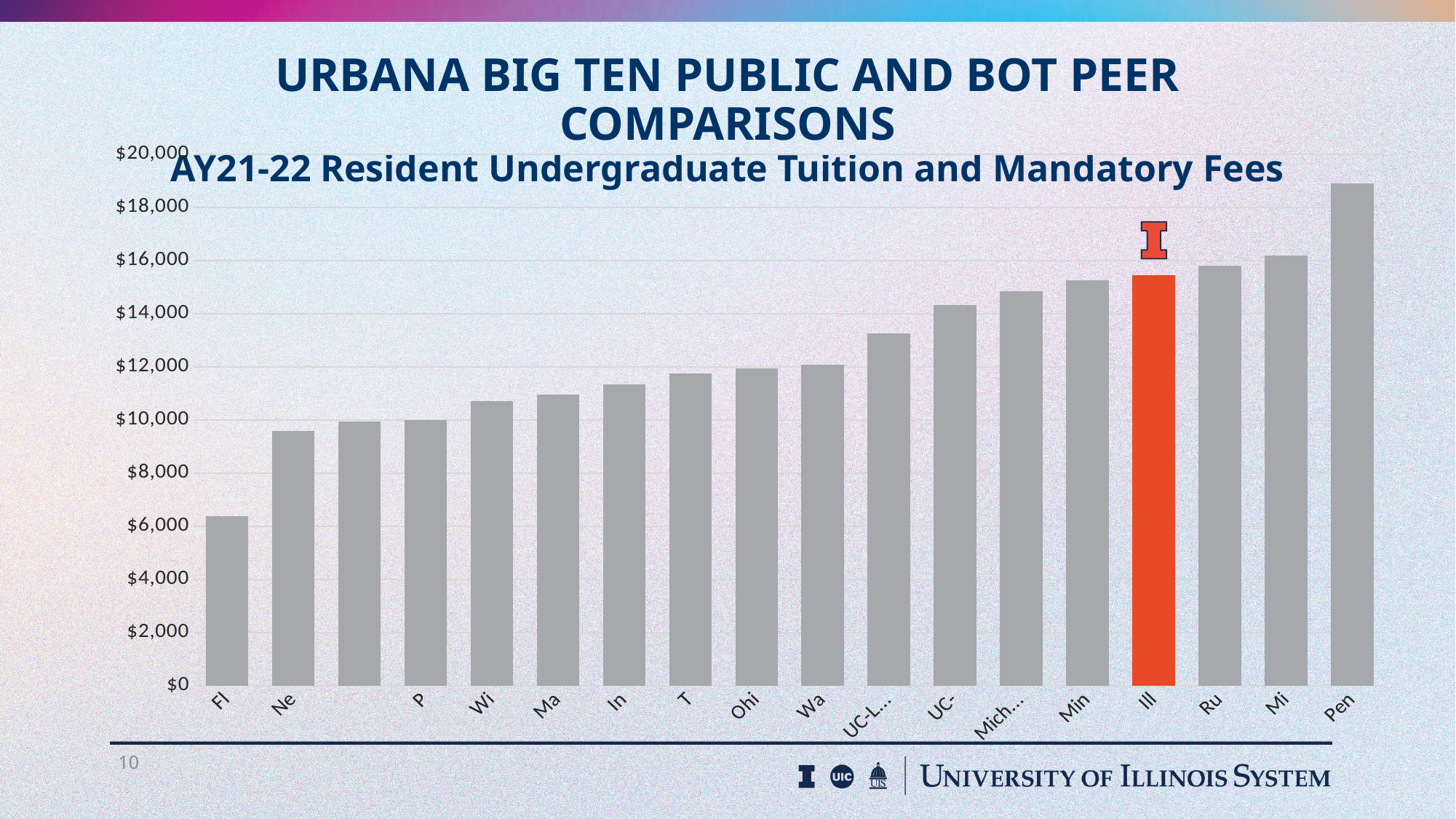
Do the values generally rise or fall from left to right along the x axis? rise Is the value for Ne greater or less than $10,000? less Is the value for Ill greater or less than $14,000? greater Is the value for UC-L... greater or less than $12,000? greater Which category has the lowest value in the chart? Fl What kind of chart is shown on the slide? Bar chart Which category has the highest value in the chart? Pen What is the title of the chart? AY21-22 Resident Undergraduate Tuition and Mandatory Fees Which category's bar is highlighted in orange? Ill Which is larger, the value for Ill or the value for Wi? Ill